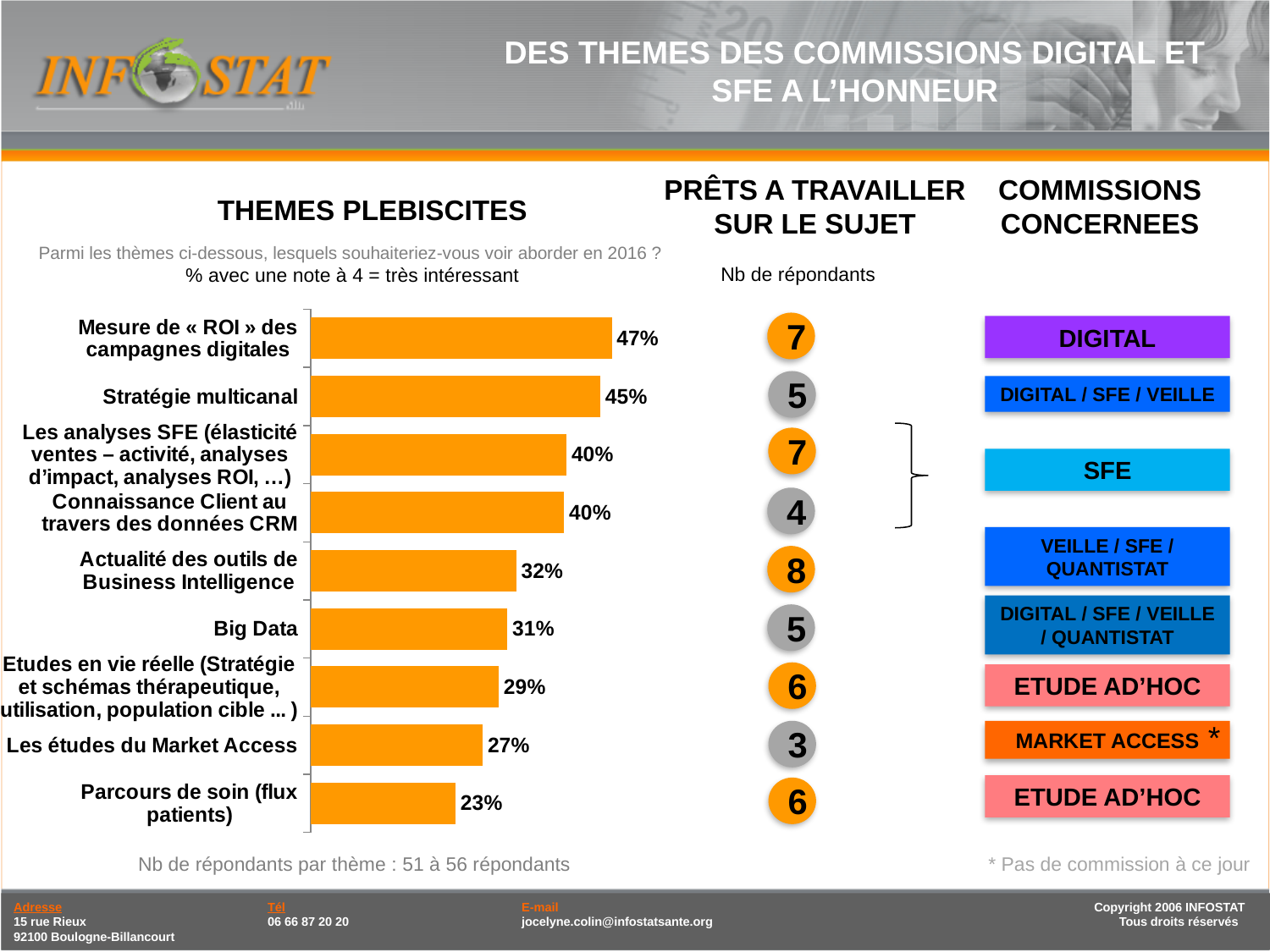
Which is larger, the value for Big Data or the value for Les études du Market Access? Big Data Which theme has the highest percentage? Mesure de « ROI » des campagnes digitales What is the title of the chart? THEMES PLEBISCITES What is the value for Les études du Market Access? 27% Which theme has the lowest percentage? Parcours de soin (flux patients) What percentage is shown for Parcours de soin (flux patients)? 23% What is the difference between the values for Actualité des outils de Business Intelligence and Parcours de soin (flux patients)? 9% How many themes are plotted in the bar chart? 9 What percentage is shown for Big Data? 31% What is the value for Stratégie multicanal? 45% What is the difference between the values for Mesure de « ROI » des campagnes digitales and Stratégie multicanal? 2% What kind of chart is used to show the themes? Bar chart